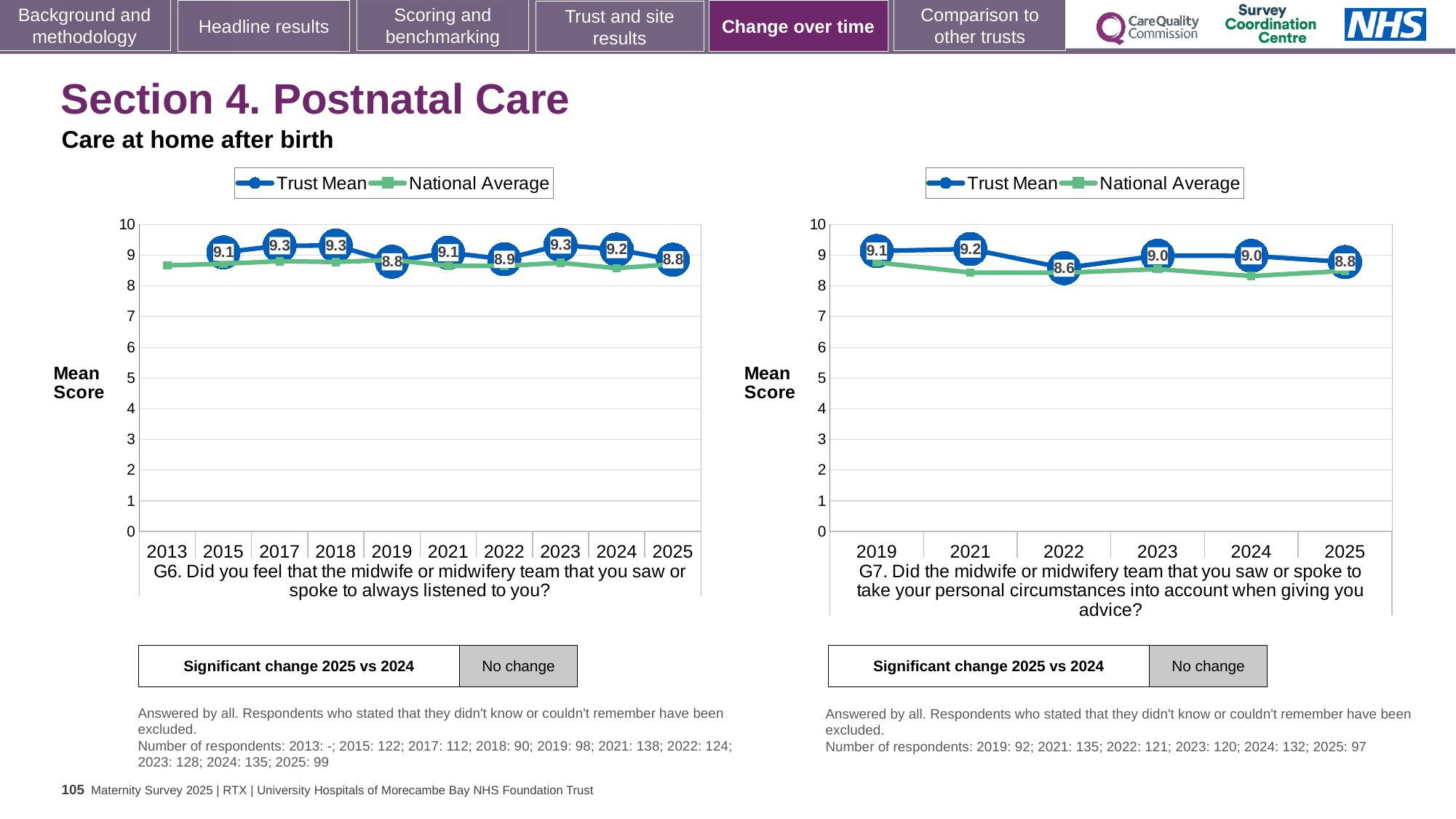
In the G6 chart on the left, what is the Trust Mean for 2025? 8.8 In the G6 chart on the left, what is the Trust Mean for 2017? 9.3 How many series does the legend of the G7 chart on the right list? 2 In the G7 chart on the right, which year has the lowest Trust Mean? 2022 How many years are shown on the x axis of the G6 chart on the left? 10 In the G6 chart on the left, which is larger: the Trust Mean for 2023 or the Trust Mean for 2025? 2023 In the G7 chart on the right, what is the difference between the Trust Mean for 2021 and the Trust Mean for 2022? 0.6 In the G7 chart on the right, which year has the highest Trust Mean? 2021 How many years are shown on the x axis of the G7 chart on the right? 6 In the G7 chart on the right, is the National Average for 2024 greater or less than 9? less In the G7 chart on the right, what is the Trust Mean for 2022? 8.6 What kind of chart is the G6 chart on the left? Line chart